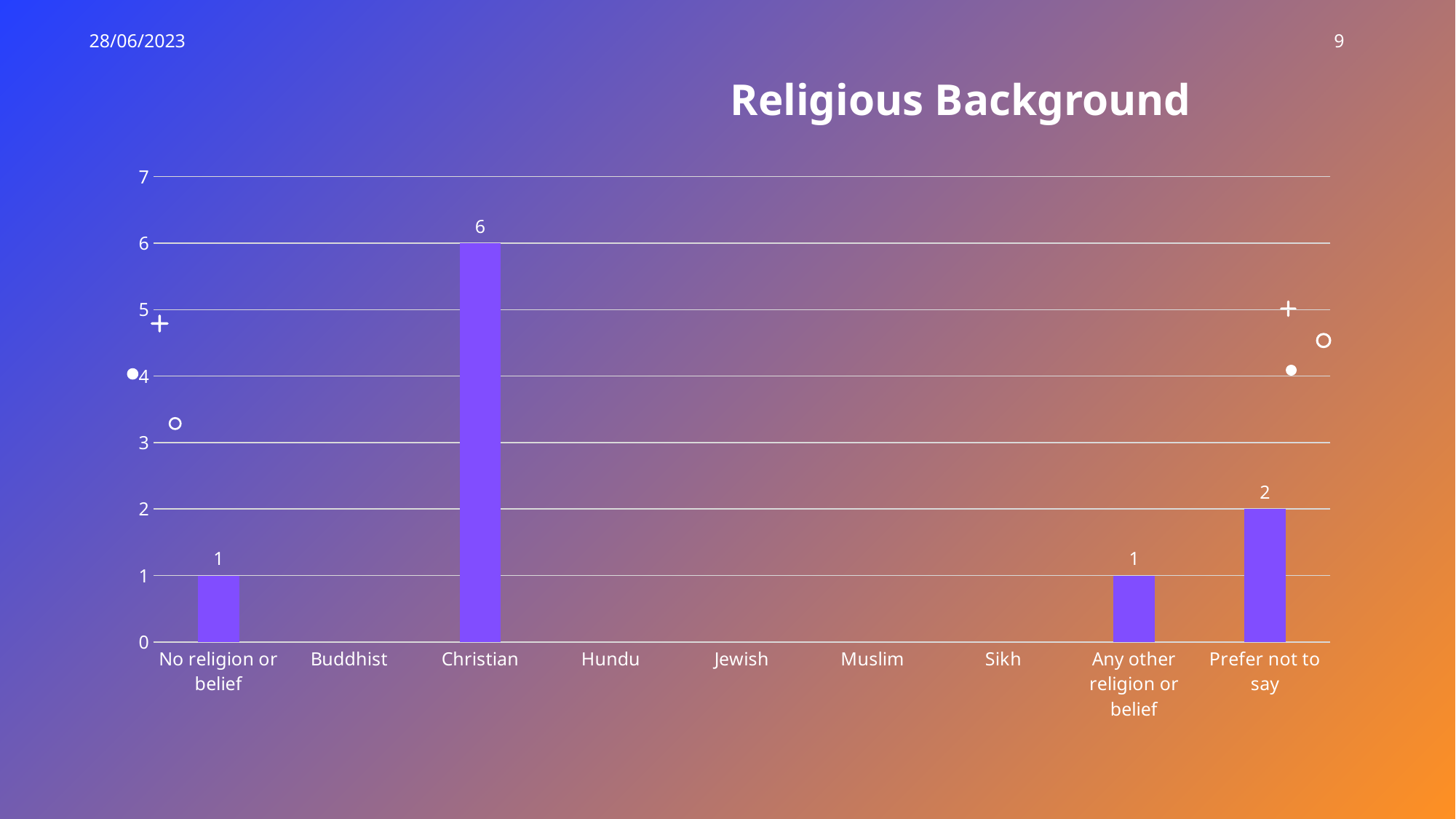
What is the value for Any other religion or belief? 1 How many categories are shown on the x axis? 9 What is the total of the values for Christian, Prefer not to say, No religion or belief and Any other religion or belief? 10 Is the value for Christian greater or less than 5? greater Which is larger, the value for Prefer not to say or the value for No religion or belief? Prefer not to say What kind of chart is shown on the slide? bar chart What is the value for Christian? 6 Which category has the highest value? Christian What is the difference between the values for Christian and Prefer not to say? 4 What is the title of the chart? Religious Background What is the value for Prefer not to say? 2 What is the value for No religion or belief? 1